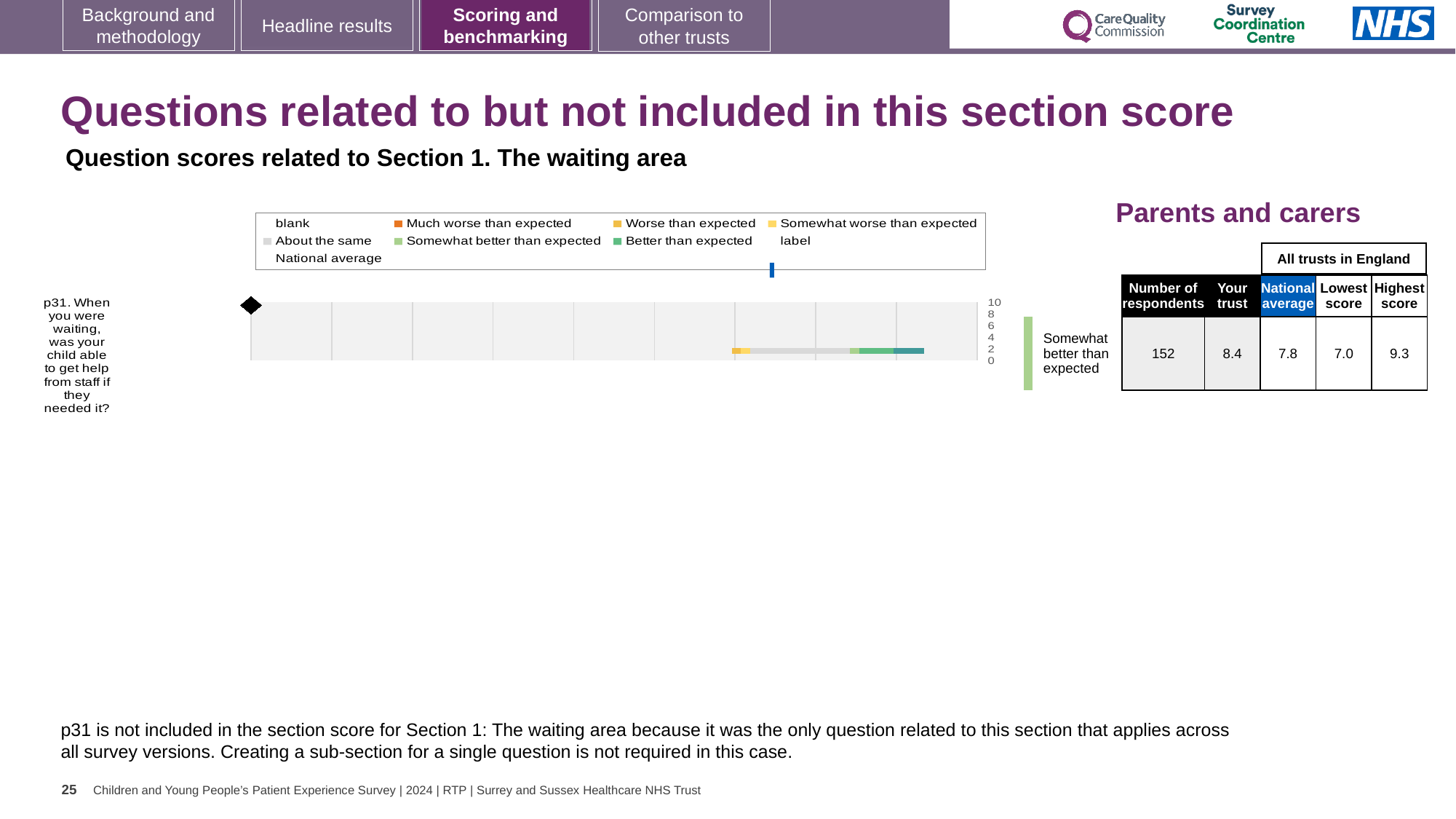
What kind of chart is used to show the benchmarking result for question p31? bar chart What is the highest score among all trusts in England for p31? 9.3 How many respondents answered question p31? 152 Which benchmarking category is shown for p31 (When you were waiting, was your child able to get help from staff if they needed it?)? Somewhat better than expected What colour in the legend represents 'Much worse than expected'? orange By how much does the 'Your trust' score for p31 exceed the national average? 0.6 How many survey questions are plotted in the chart? 1 What is the 'Your trust' score for p31? 8.4 What is the difference between the highest and lowest scores for p31 across all trusts in England? 2.3 Which is higher for p31: the 'Your trust' score or the national average? Your trust What is the national average score for p31? 7.8 What is the lowest score among all trusts in England for p31? 7.0